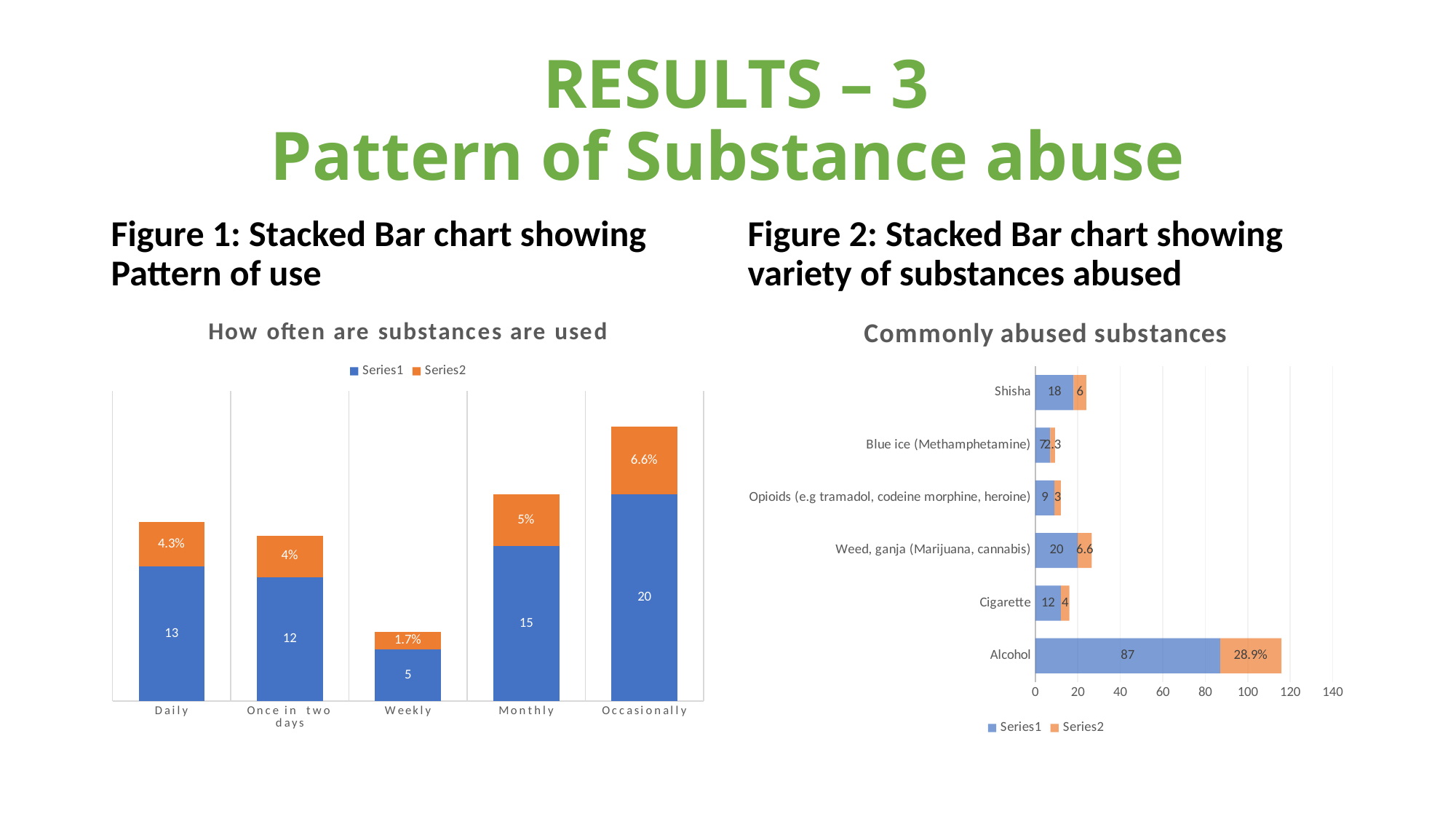
In the chart titled "Commonly abused substances", what is the Series1 value for Alcohol? 87 In the chart titled "How often are substances are used", what is the Series2 value for Occasionally? 6.6% In the chart titled "How often are substances are used", which category has the highest Series1 value? Occasionally In the chart titled "Commonly abused substances", is the total length of the Alcohol bar greater or less than 100? greater What kind of chart is the chart titled "Commonly abused substances"? Stacked bar chart In the chart titled "Commonly abused substances", what is the Series2 value for Weed, ganja (Marijuana, cannabis)? 6.6 In the chart titled "How often are substances are used", which category has the lowest Series1 value? Weekly In the chart titled "Commonly abused substances", which substance has the highest Series1 value? Alcohol In the chart titled "How often are substances are used", what is the difference between the Series1 values for Monthly and Once in two days? 3 In the chart titled "Commonly abused substances", which is larger, the Series1 value for Shisha or for Cigarette? Shisha In the chart titled "How often are substances are used", what is the Series1 value for Daily? 13 In the chart titled "How often are substances are used", how many categories are shown on the x axis? 5